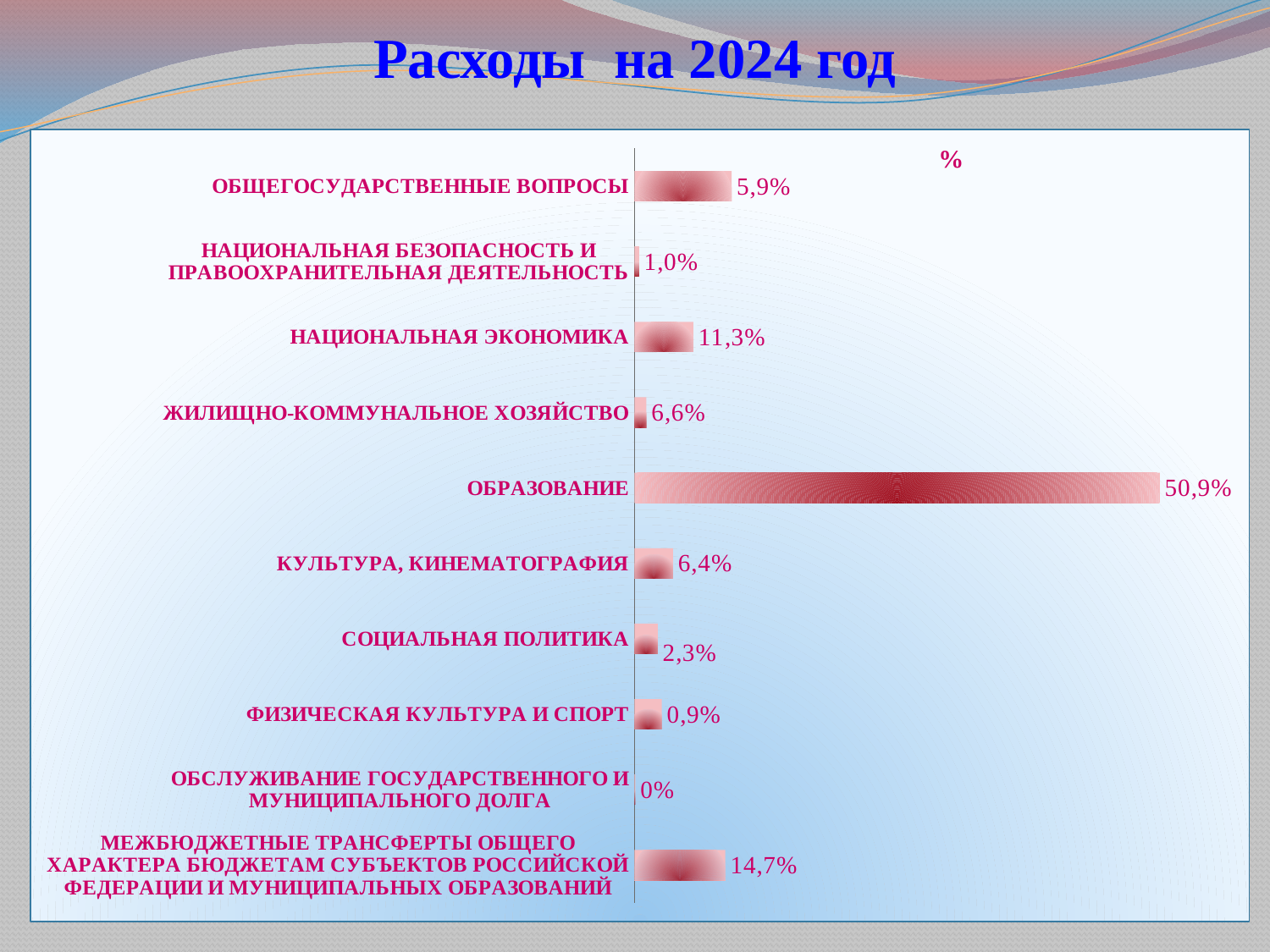
What is the value for НАЦИОНАЛЬНАЯ ЭКОНОМИКА? 11,3% What is the value for ФИЗИЧЕСКАЯ КУЛЬТУРА И СПОРТ? 0,9% How many categories are shown in the chart? 10 Which is larger: the value for СОЦИАЛЬНАЯ ПОЛИТИКА or the value for КУЛЬТУРА, КИНЕМАТОГРАФИЯ? КУЛЬТУРА, КИНЕМАТОГРАФИЯ What is the title of the chart on the slide? % Which category has the lowest value? ОБСЛУЖИВАНИЕ ГОСУДАРСТВЕННОГО И МУНИЦИПАЛЬНОГО ДОЛГА What is the difference between the values for ОБРАЗОВАНИЕ and НАЦИОНАЛЬНАЯ ЭКОНОМИКА? 39,6% What type of chart is shown on the slide? Bar chart What is the value for МЕЖБЮДЖЕТНЫЕ ТРАНСФЕРТЫ ОБЩЕГО ХАРАКТЕРА БЮДЖЕТАМ СУБЪЕКТОВ РОССИЙСКОЙ ФЕДЕРАЦИИ И МУНИЦИПАЛЬНЫХ ОБРАЗОВАНИЙ? 14,7% What is the value for ОБРАЗОВАНИЕ? 50,9% Which category has the highest value? ОБРАЗОВАНИЕ What is the difference between the values for ОБЩЕГОСУДАРСТВЕННЫЕ ВОПРОСЫ and НАЦИОНАЛЬНАЯ БЕЗОПАСНОСТЬ И ПРАВООХРАНИТЕЛЬНАЯ ДЕЯТЕЛЬНОСТЬ? 4,9%